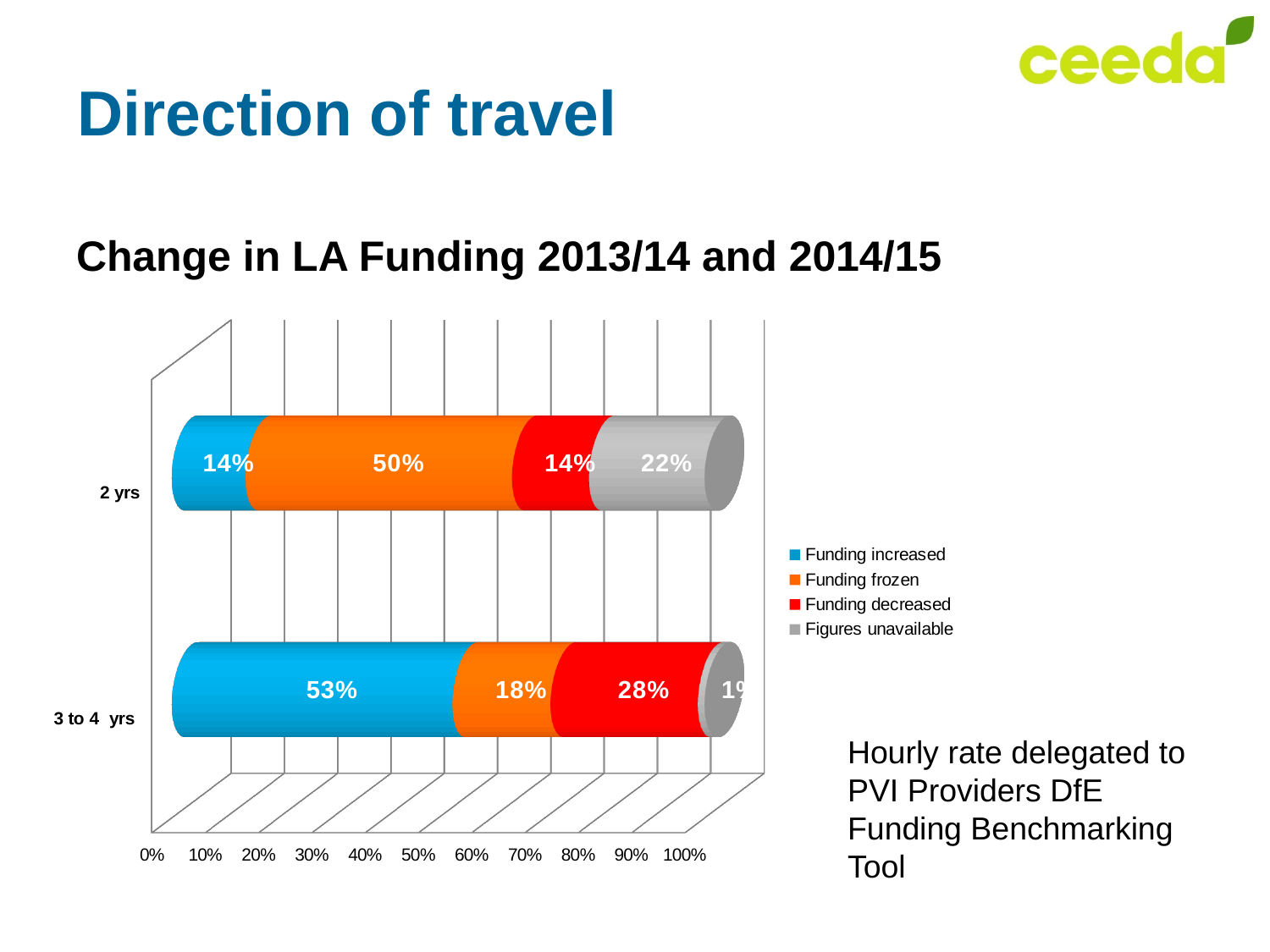
What percentage of 3 to 4 yrs had funding decreased? 28% What percentage of 2 yrs had figures unavailable? 22% Which age group has the larger share with funding increased, 2 yrs or 3 to 4 yrs? 3 to 4 yrs How many age group categories are plotted on the chart? 2 What kind of chart is shown on the slide? Stacked bar chart What percentage of 2 yrs had funding frozen? 50% What percentage of 3 to 4 yrs had funding increased? 53% How many series does the legend list? 4 What is the title of the chart? Change in LA Funding 2013/14 and 2014/15 What percentage of 2 yrs had funding increased? 14% Which series is shown in orange in the legend? Funding frozen What is the difference between the funding frozen share for 2 yrs and for 3 to 4 yrs? 32%